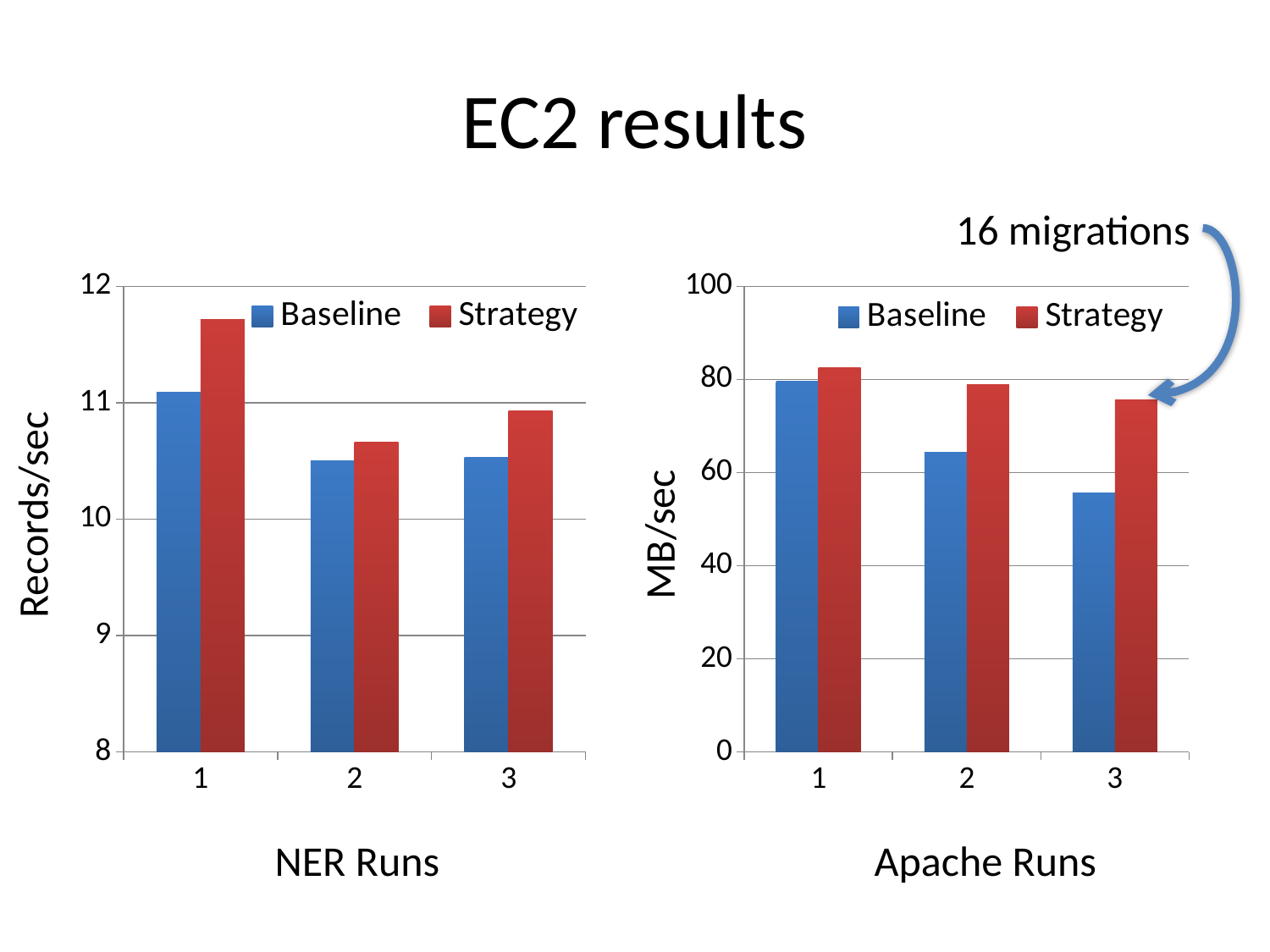
In the Apache Runs chart, do the Baseline values rise or fall from run 1 to run 3? fall In the NER Runs chart, which run has the highest Strategy value? 1 In the Apache Runs chart, how many runs are shown on the x axis? 3 In the NER Runs chart, is the Baseline value for run 2 greater or less than 11? less In the Apache Runs chart, which run has the lowest Baseline value? 3 In the Apache Runs chart, which run has the highest Baseline value? 1 What kind of chart is the NER Runs chart on the left? bar chart What is the y-axis label of the Apache Runs chart? MB/sec In the Apache Runs chart, which is larger for run 2, Baseline or Strategy? Strategy In the Apache Runs chart, is the Baseline value for run 3 greater or less than 60? less In the NER Runs chart, how many series does the legend list? 2 In the NER Runs chart, is the Strategy value for run 1 greater or less than 11? greater